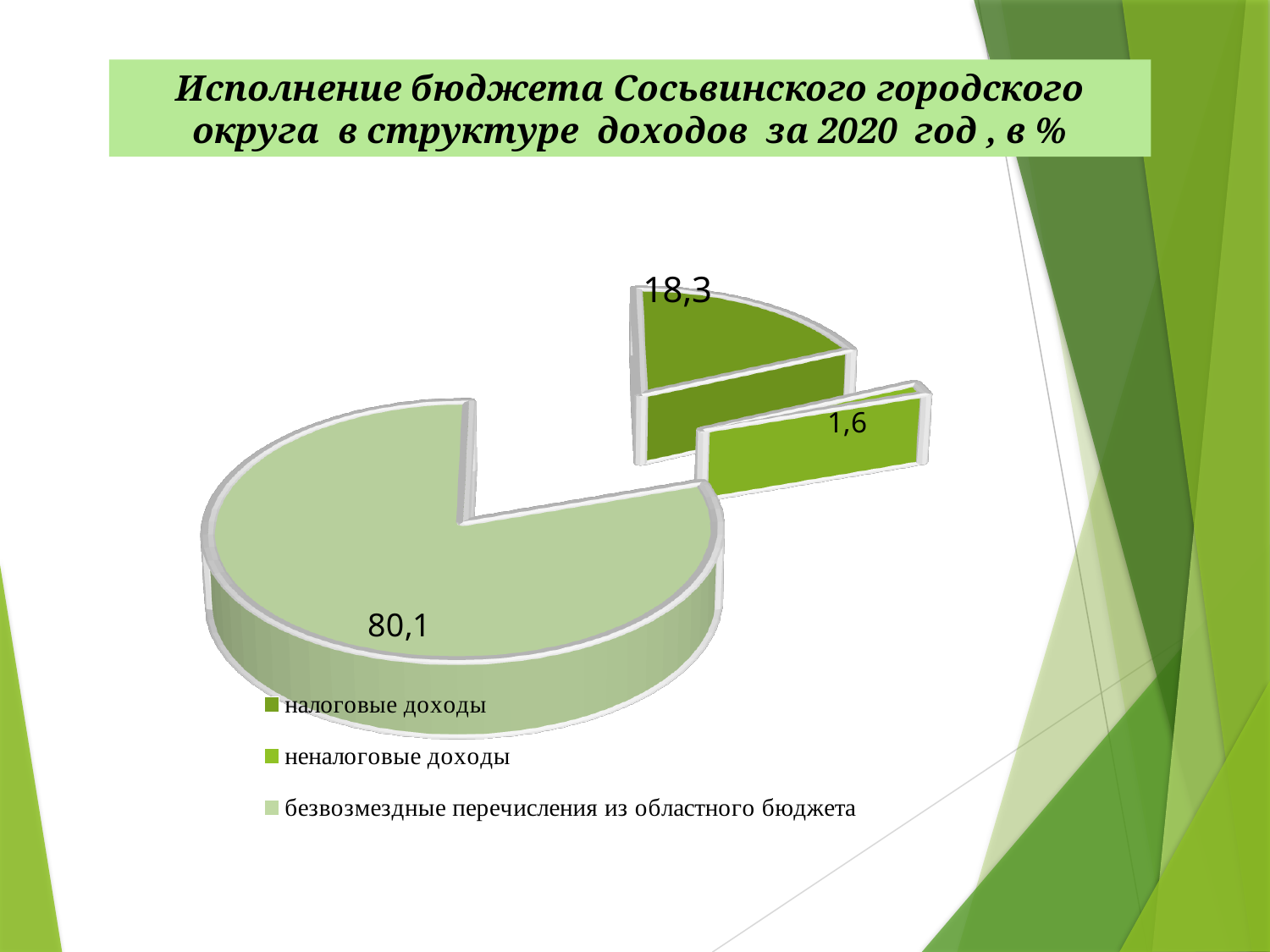
What is the difference between the values for налоговые доходы and неналоговые доходы? 16,7 Which is larger: налоговые доходы or неналоговые доходы? налоговые доходы How many entries does the legend list? 3 What is the difference between the values for безвозмездные перечисления из областного бюджета and налоговые доходы? 61,8 What year does the chart title refer to? 2020 Which category has the smallest slice? неналоговые доходы What is the value for безвозмездные перечисления из областного бюджета? 80,1 What is the value for налоговые доходы? 18,3 What is the value for неналоговые доходы? 1,6 How many slices does the pie chart have? 3 What type of chart is shown on the slide? Pie chart Which category has the largest slice? безвозмездные перечисления из областного бюджета